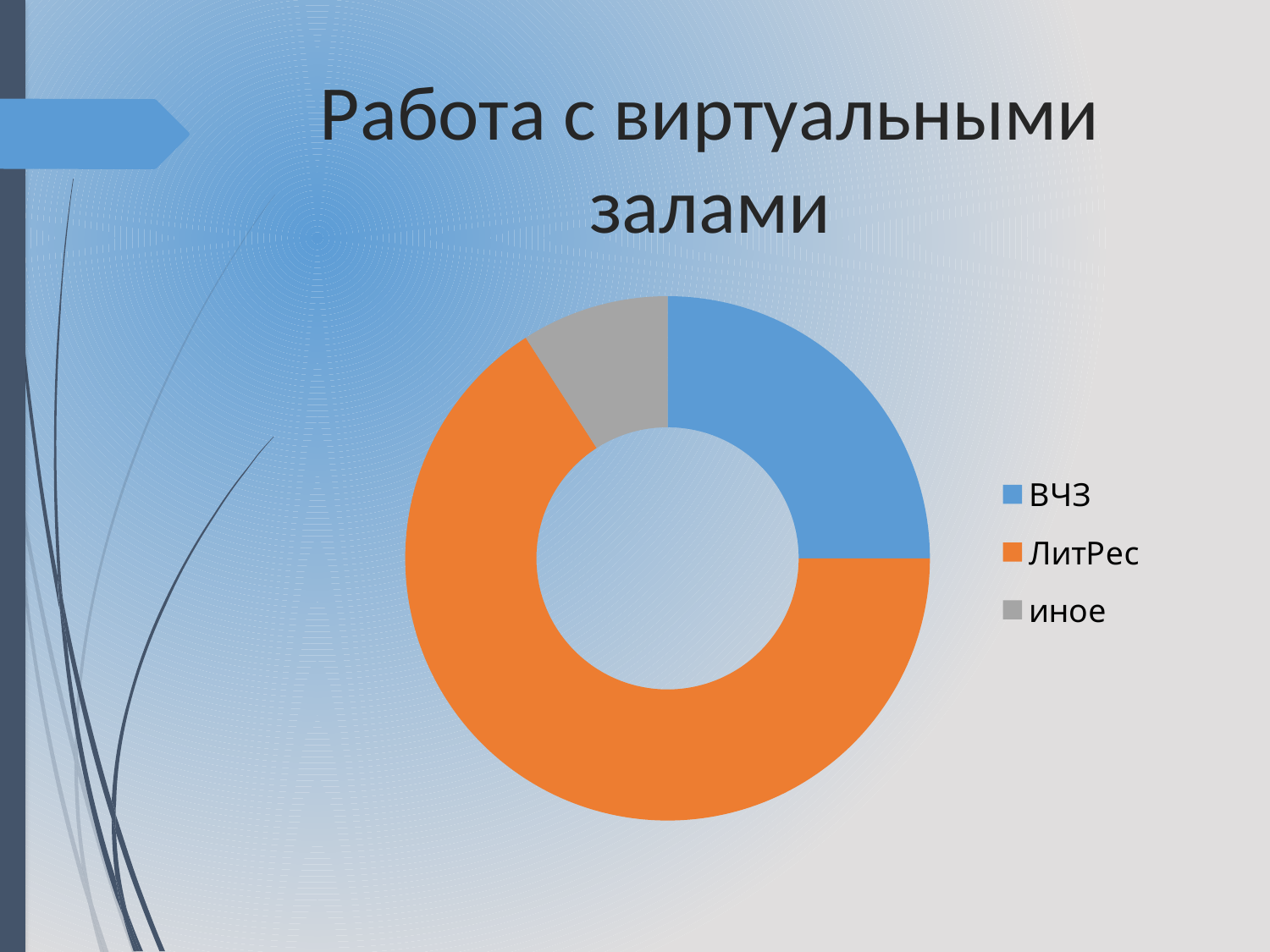
How many entries does the legend list? 3 Which has a larger share, ЛитРес or ВЧЗ? ЛитРес What colour represents ЛитРес in the chart? Orange What is the title of the slide containing the chart? Работа с виртуальными залами What kind of chart is shown on the slide? Doughnut chart Which category has the smallest share of the chart? иное How many categories does the chart show? 3 Which category has the largest share of the chart? ЛитРес Which has a larger share, ВЧЗ or иное? ВЧЗ